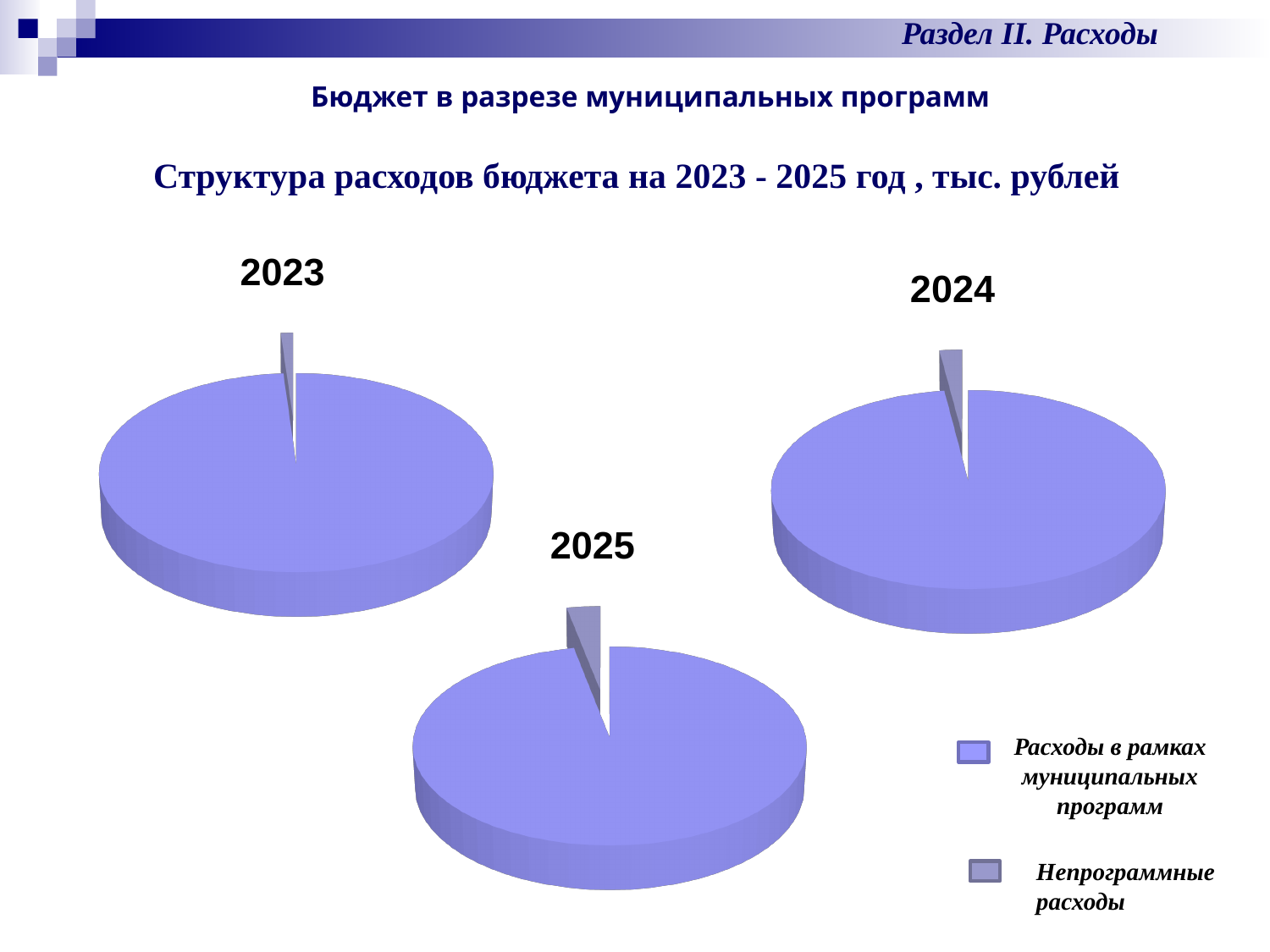
How many slices does the 2024 pie chart have? 2 In the 2025 pie chart, which is larger: Расходы в рамках муниципальных программ or Непрограммные расходы? Расходы в рамках муниципальных программ How many pie charts are shown on the slide? 3 What is the title shown above the three pie charts? Структура расходов бюджета на 2023 - 2025 год , тыс. рублей What kind of chart is the 2025 chart? pie chart Which years are the three pie charts labelled with? 2023, 2024, 2025 How many categories does the legend list? 2 In the 2024 pie chart, which category has the smallest share? Непрограммные расходы In the 2023 pie chart, which is smaller: Расходы в рамках муниципальных программ or Непрограммные расходы? Непрограммные расходы What kind of chart is the 2023 chart? pie chart In the 2023 pie chart, which category has the largest share? Расходы в рамках муниципальных программ